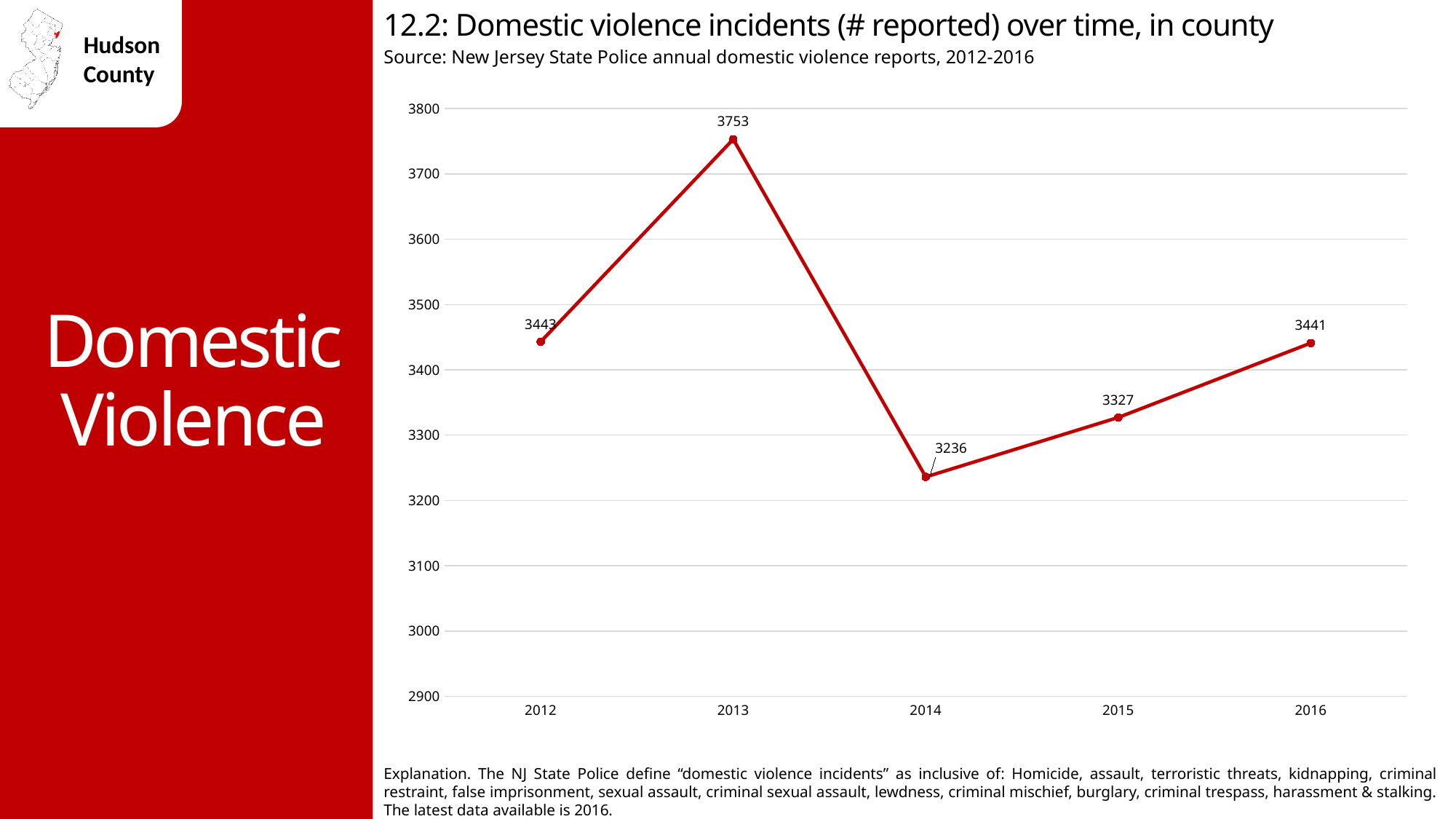
Which year had the highest number of reported domestic violence incidents? 2013 Did the number of reported incidents rise or fall from 2014 to 2016? rise Is the value for 2015 greater or less than 3400? less Which year had more reported incidents, 2015 or 2016? 2016 Which year had the lowest number of reported domestic violence incidents? 2014 What was the number of reported domestic violence incidents in 2013? 3753 What is the difference between the number of incidents in 2013 and 2014? 517 What was the number of reported domestic violence incidents in 2016? 3441 What is the difference between the number of incidents in 2012 and 2016? 2 What was the number of reported domestic violence incidents in 2014? 3236 What kind of chart is shown on the slide? line chart How many years are plotted on the chart? 5